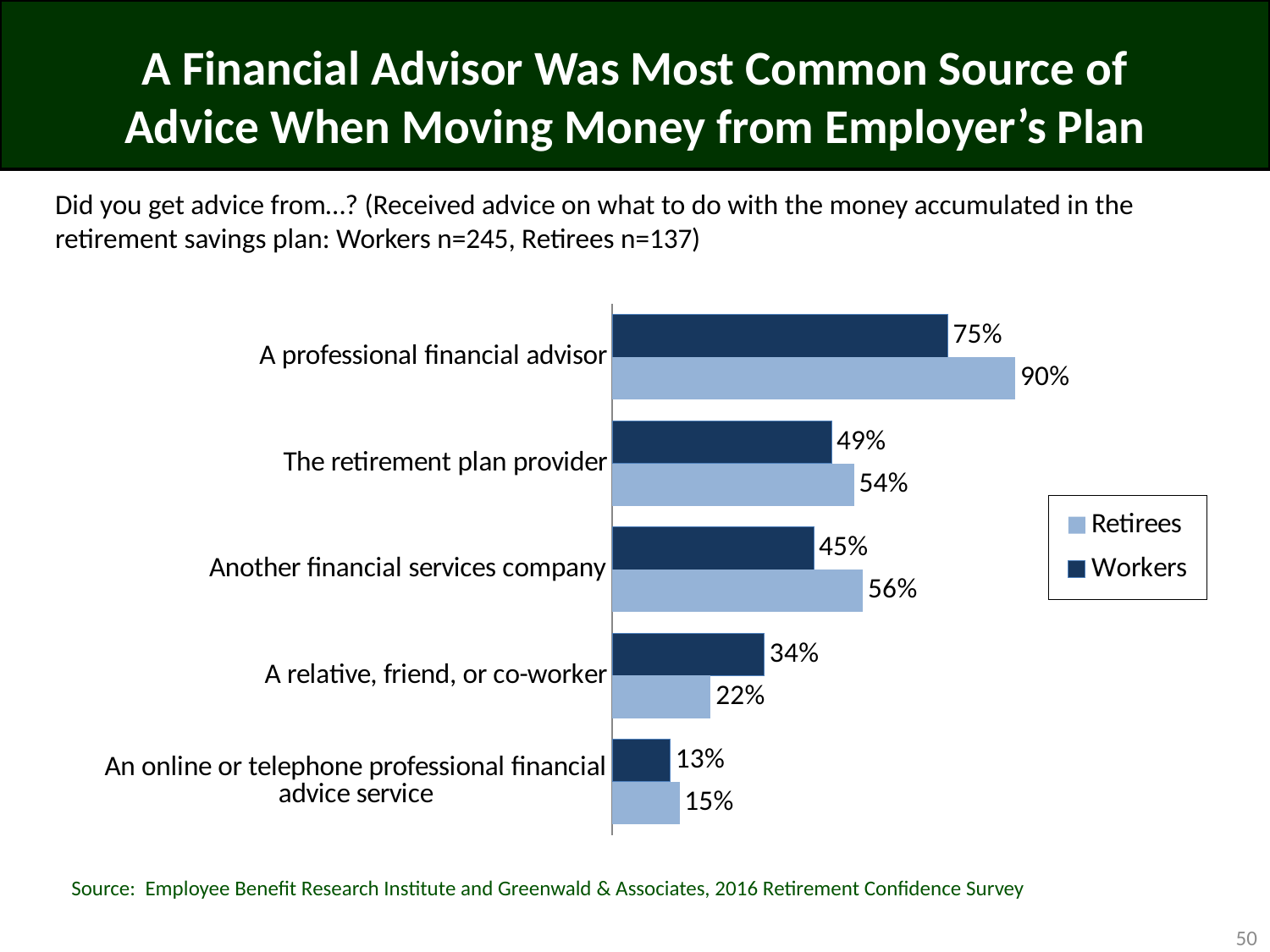
What percentage of Workers got advice from a relative, friend, or co-worker? 34% What kind of chart is shown on the slide? Bar chart What is the difference between the Workers and Retirees values for a relative, friend, or co-worker? 12% What percentage of Retirees got advice from a professional financial advisor? 90% Which source of advice has the lowest value for Retirees? An online or telephone professional financial advice service What percentage of Workers got advice from the retirement plan provider? 49% How many sources of advice are shown in the chart? 5 What is the difference between the Retirees and Workers values for a professional financial advisor? 15% How many series does the legend list? 2 What percentage of Retirees got advice from an online or telephone professional financial advice service? 15% For another financial services company, which group has the larger value, Workers or Retirees? Retirees Which source of advice has the highest value for Workers? A professional financial advisor